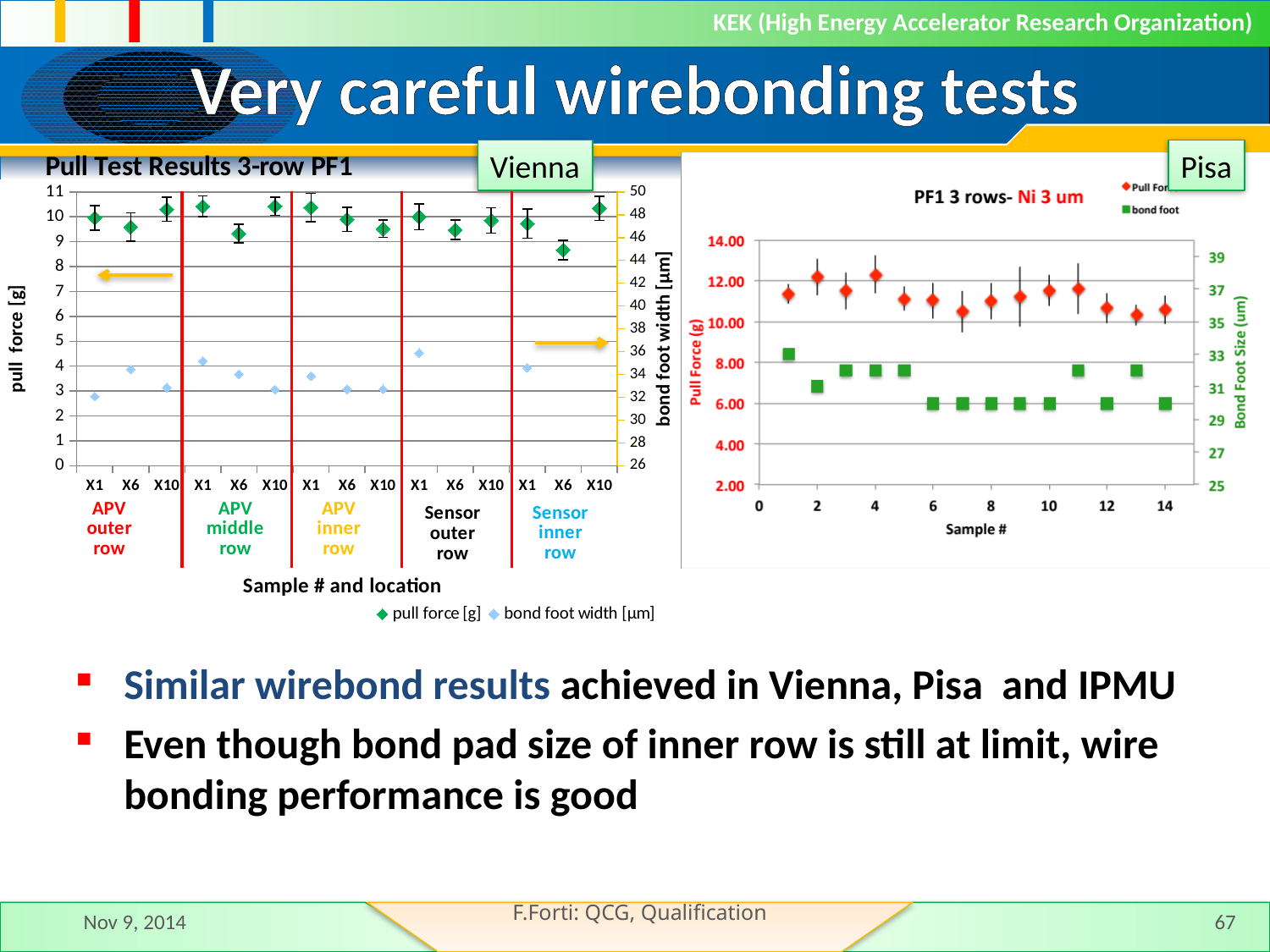
What is the title of the right chart (Pisa)? PF1 3 rows- Ni 3 um How many samples are plotted in the right chart (PF1 3 rows- Ni 3 um)? 14 In the right chart (PF1 3 rows- Ni 3 um), is the pull force for sample 13 greater or less than 12.00? less How many series does the legend of the left chart (Pull Test Results 3-row PF1) list? 2 What kind of chart is the left chart titled "Pull Test Results 3-row PF1"? scatter chart In the left chart (Pull Test Results 3-row PF1), which sample has the lowest pull force? X6 of the Sensor inner row What are the two series named in the legend of the left chart (Pull Test Results 3-row PF1)? pull force [g] and bond foot width [µm] How many row groups (locations) are labelled along the x axis of the left chart (Pull Test Results 3-row PF1)? 5 In the left chart (Pull Test Results 3-row PF1), which has the larger bond foot width: X1 of the Sensor outer row or X1 of the APV outer row? X1 of the Sensor outer row In the left chart (Pull Test Results 3-row PF1), is the pull force for X6 of the Sensor inner row greater or less than 10? less In the right chart (PF1 3 rows- Ni 3 um), which sample has the largest bond foot size? Sample 1 In the left chart (Pull Test Results 3-row PF1), is the pull force for X1 of the APV outer row greater or less than 9? greater